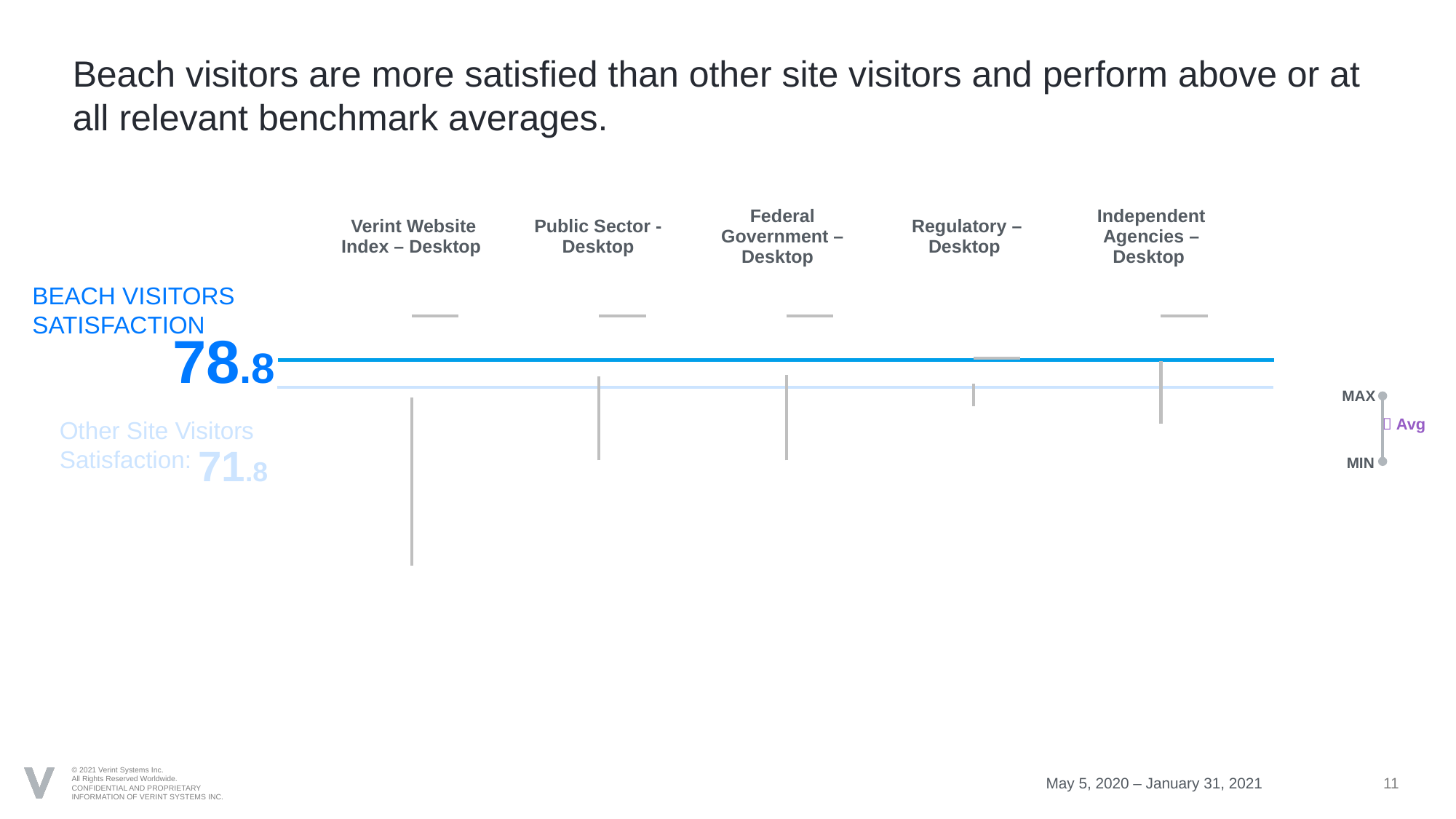
What is the Other Site Visitors Satisfaction score shown on the chart? 71.8 Which benchmark category has the lowest minimum value on the chart? Verint Website Index – Desktop How many benchmark categories are shown across the top of the chart? 5 What three markers does the legend on the right of the chart explain? MAX, Avg, MIN Which benchmark category has the lowest maximum value on the chart? Regulatory – Desktop What is the date range shown at the bottom of the slide for the chart data? May 5, 2020 – January 31, 2021 Which benchmark category has the lowest average marker on the chart? Verint Website Index – Desktop Is the Beach Visitors Satisfaction score greater or less than 75? greater Which is higher, the Beach Visitors Satisfaction score or the Other Site Visitors Satisfaction score? Beach Visitors Satisfaction What is the difference between the Beach Visitors Satisfaction score and the Other Site Visitors Satisfaction score? 7.0 What is the Beach Visitors Satisfaction score shown on the chart? 78.8